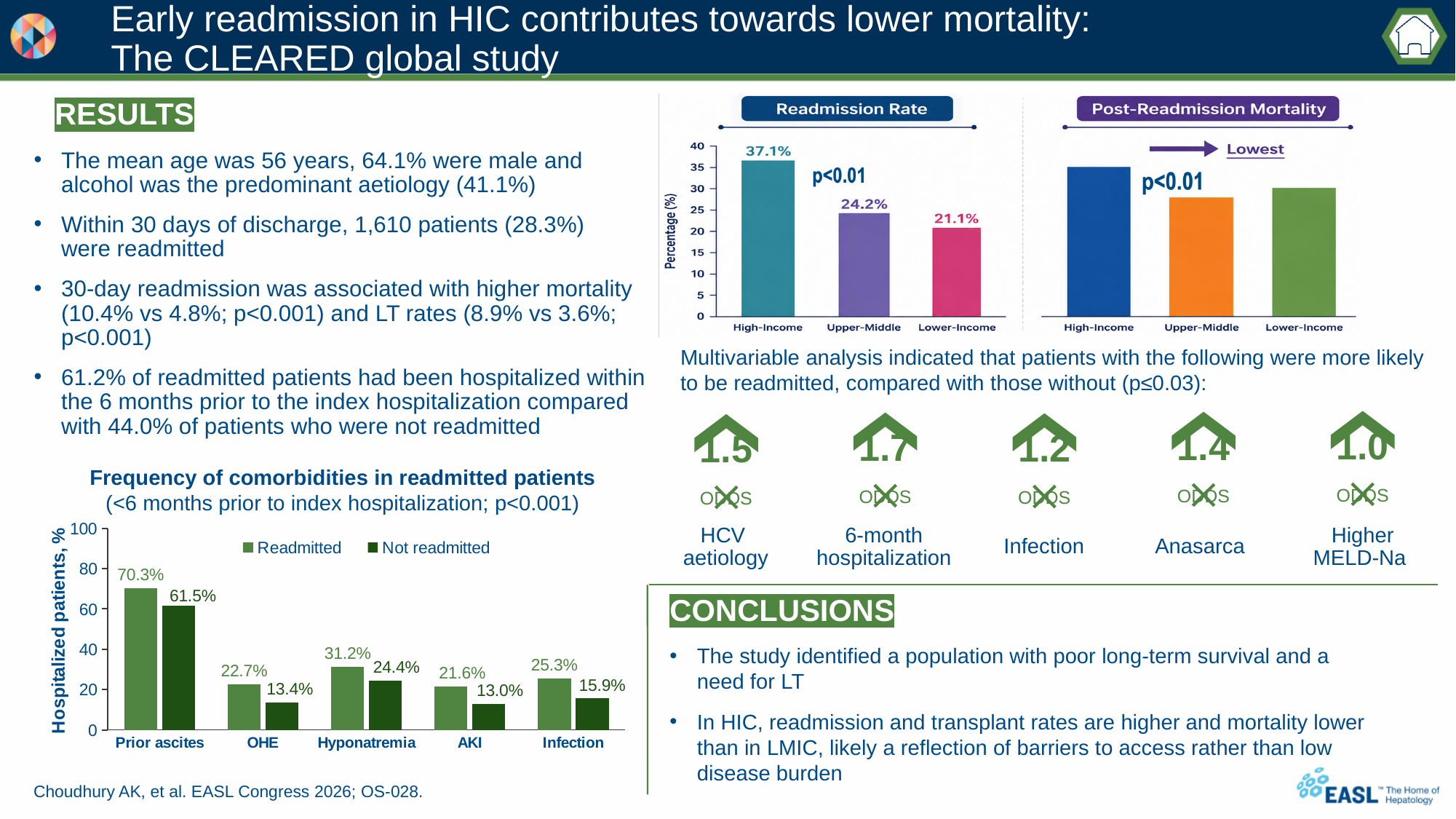
In the 'Readmission Rate' chart, what is the readmission rate for the Upper-Middle income group? 24.2% In the 'Frequency of comorbidities in readmitted patients' chart, how many comorbidity categories are shown on the x axis? 5 In the 'Frequency of comorbidities in readmitted patients' chart, what is the difference between the Readmitted and Not readmitted values for OHE? 9.3% In the 'Frequency of comorbidities in readmitted patients' chart, which comorbidity has the highest value among readmitted patients? Prior ascites In the 'Frequency of comorbidities in readmitted patients' chart, what is the value for Not readmitted patients with hyponatremia? 24.4% In the 'Frequency of comorbidities in readmitted patients' chart, which comorbidity has the lowest value among Not readmitted patients? AKI What kind of chart is the 'Frequency of comorbidities in readmitted patients' chart? Bar chart In the 'Frequency of comorbidities in readmitted patients' chart, what percentage of readmitted patients had prior ascites? 70.3% In the 'Frequency of comorbidities in readmitted patients' chart, how many series does the legend list? 2 In the 'Readmission Rate' chart, do the values rise or fall from High-Income to Lower-Income? Fall In the 'Readmission Rate' chart, what is the difference between the High-Income and Lower-Income readmission rates? 16.0%